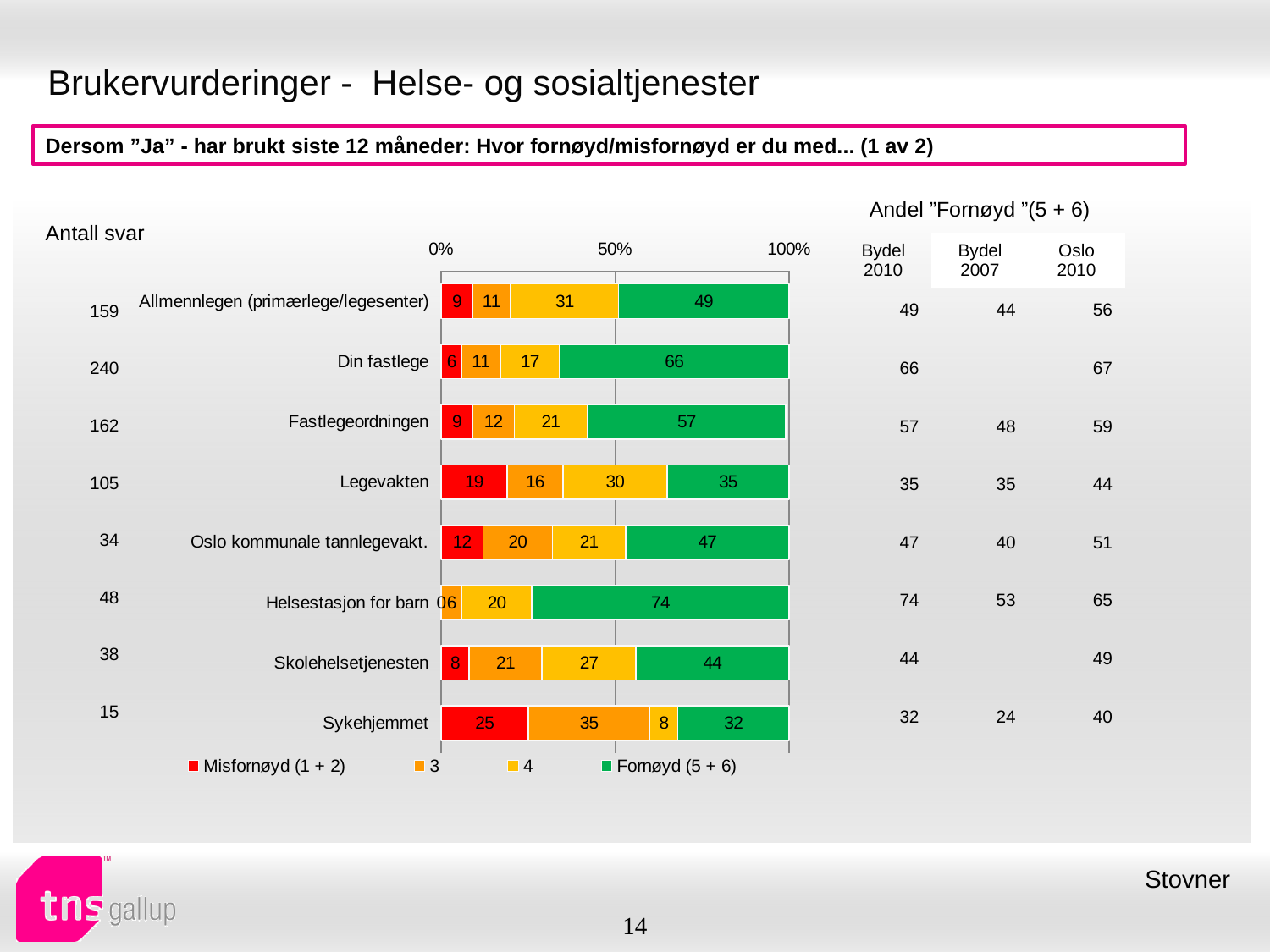
Which category has the highest Fornøyd (5 + 6) value? Helsestasjon for barn Which category has the highest Misfornøyd (1 + 2) value? Sykehjemmet What is the total of the stacked bar for Sykehjemmet? 100 Which category has the lowest Fornøyd (5 + 6) value? Sykehjemmet How many series does the legend list? 4 What is the value of the Misfornøyd (1 + 2) segment for Sykehjemmet? 25 What is the value of the Fornøyd (5 + 6) segment for Din fastlege? 66 What kind of chart is shown on the slide? Stacked bar chart How many categories are shown in the bar chart? 8 Which has a larger Misfornøyd (1 + 2) value: Legevakten or Oslo kommunale tannlegevakt.? Legevakten What is the difference between the Fornøyd (5 + 6) values for Din fastlege and Legevakten? 31 What is the value of the '4' segment for Allmennlegen (primærlege/legesenter)? 31